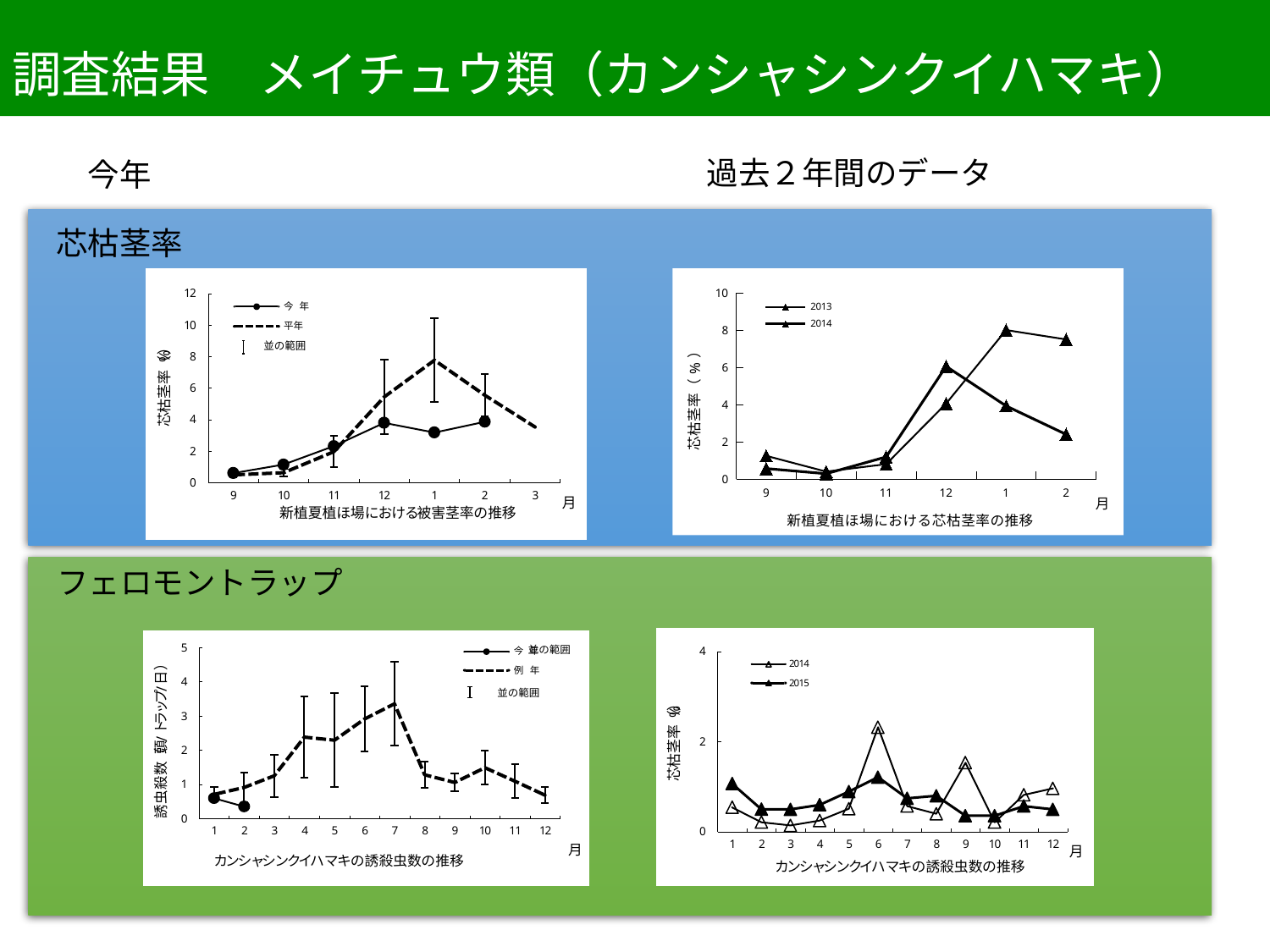
In the bottom-right chart (カンシャシンクイハマキの誘殺虫数の推移, 過去2年間), is the value for 2014 in month 6 greater or less than 2? greater In the top-right chart (新植夏植ほ場における芯枯茎率の推移), in which month does the 2013 series reach its highest value? 1 In the top-right chart (新植夏植ほ場における芯枯茎率の推移), how many series does the legend list? 2 In the bottom-left chart (カンシャシンクイハマキの誘殺虫数の推移, 今年), in which month does the 例年 series reach its highest value? 7 In the top-left chart (新植夏植ほ場における被害茎率の推移), is the 平年 value in month 1 greater or less than 6? greater How many month ticks are shown on the x axis of the top-left chart (新植夏植ほ場における被害茎率の推移)? 7 In the top-right chart (新植夏植ほ場における芯枯茎率の推移), is the value for 2013 in month 1 greater or less than 6? greater Which two years are listed in the legend of the bottom-right chart? 2014 and 2015 In the bottom-right chart (カンシャシンクイハマキの誘殺虫数の推移, 過去2年間), which series has the larger value in month 6, 2014 or 2015? 2014 What kind of chart is the top-left chart (新植夏植ほ場における被害茎率の推移)? line chart In the top-left chart (新植夏植ほ場における被害茎率の推移), does the 今年 series rise or fall from month 9 to month 12? rise